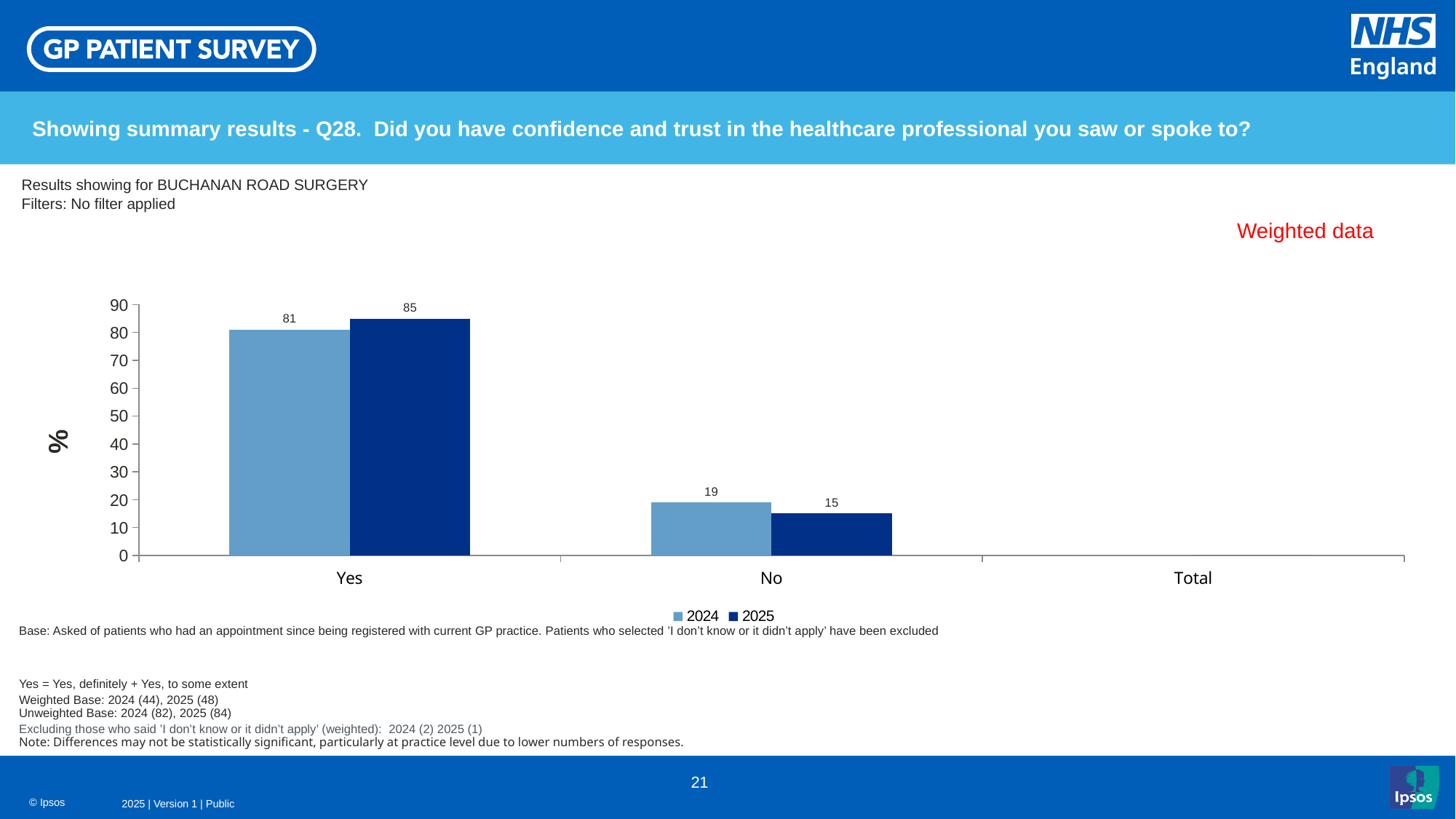
What is the value for No in 2024? 19 What is the value for Yes in 2025? 85 What is the value for No in 2025? 15 Which is larger, the 2024 value for No or the 2025 value for No? 2024 What is the difference between the 2025 and 2024 values for Yes? 4 How many series does the legend list? 2 What kind of chart is shown on the slide? Bar chart Which category has the highest value in the 2025 series? Yes Is the value for Yes in 2025 greater or less than 80? greater What is the difference between the 2024 and 2025 values for No? 4 What label is shown on the vertical axis? % What is the value for Yes in 2024? 81